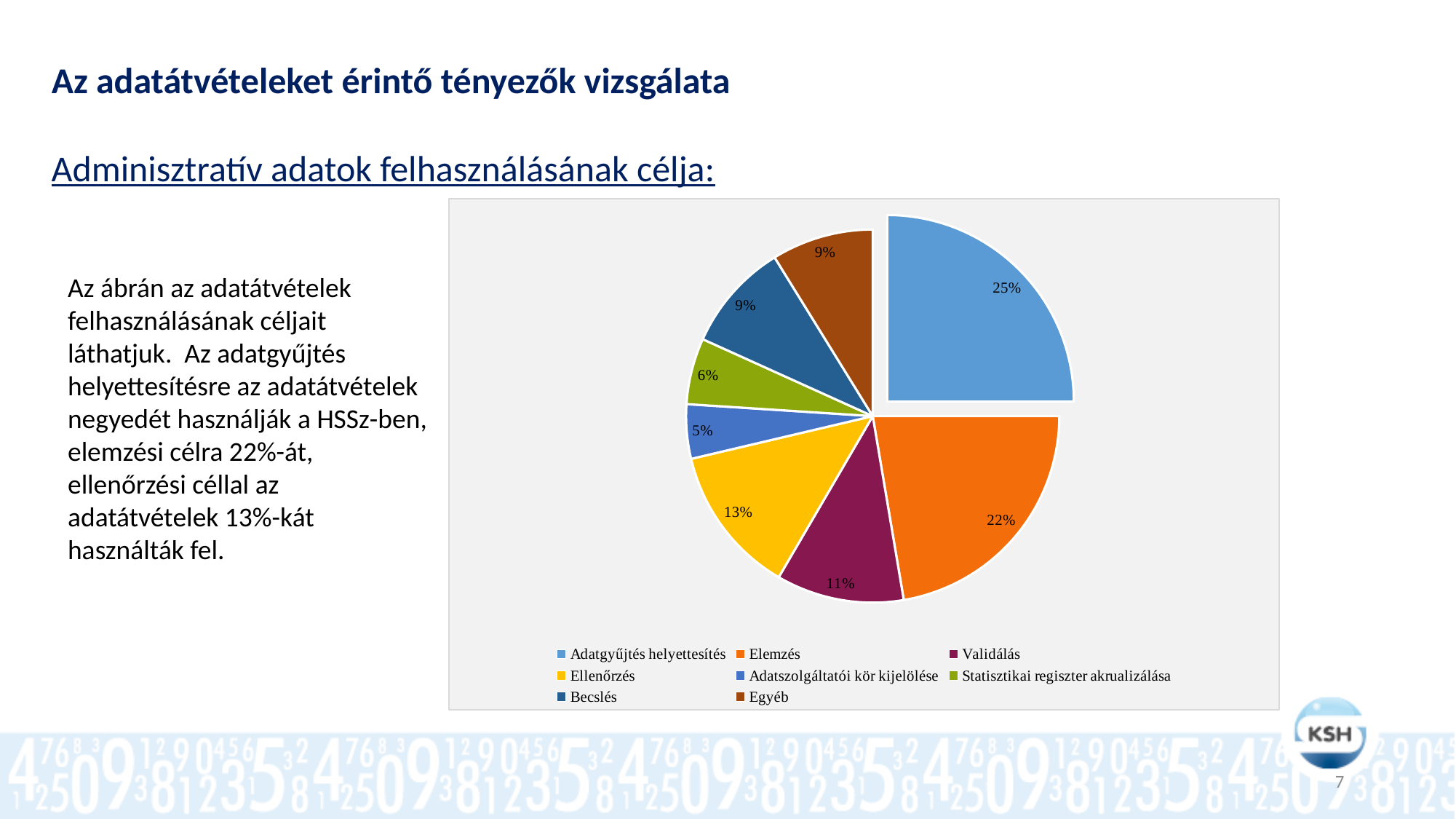
What kind of chart is shown on the slide? pie chart Which category has the largest slice of the pie? Adatgyűjtés helyettesítés What share of the pie does Ellenőrzés have? 13% Which slice of the pie is pulled out (exploded) from the rest? Adatgyűjtés helyettesítés What share of the pie does Adatgyűjtés helyettesítés have? 25% Which category has the smallest slice of the pie? Adatszolgáltatói kör kijelölése What share of the pie does Validálás have? 11% What share of the pie does Elemzés have? 22% Which is larger, the share for Ellenőrzés or the share for Validálás? Ellenőrzés What is the difference in percentage points between Adatgyűjtés helyettesítés and Elemzés? 3 What share of the pie does Statisztikai regiszter akrualizálása have? 6% How many categories does the legend list? 8